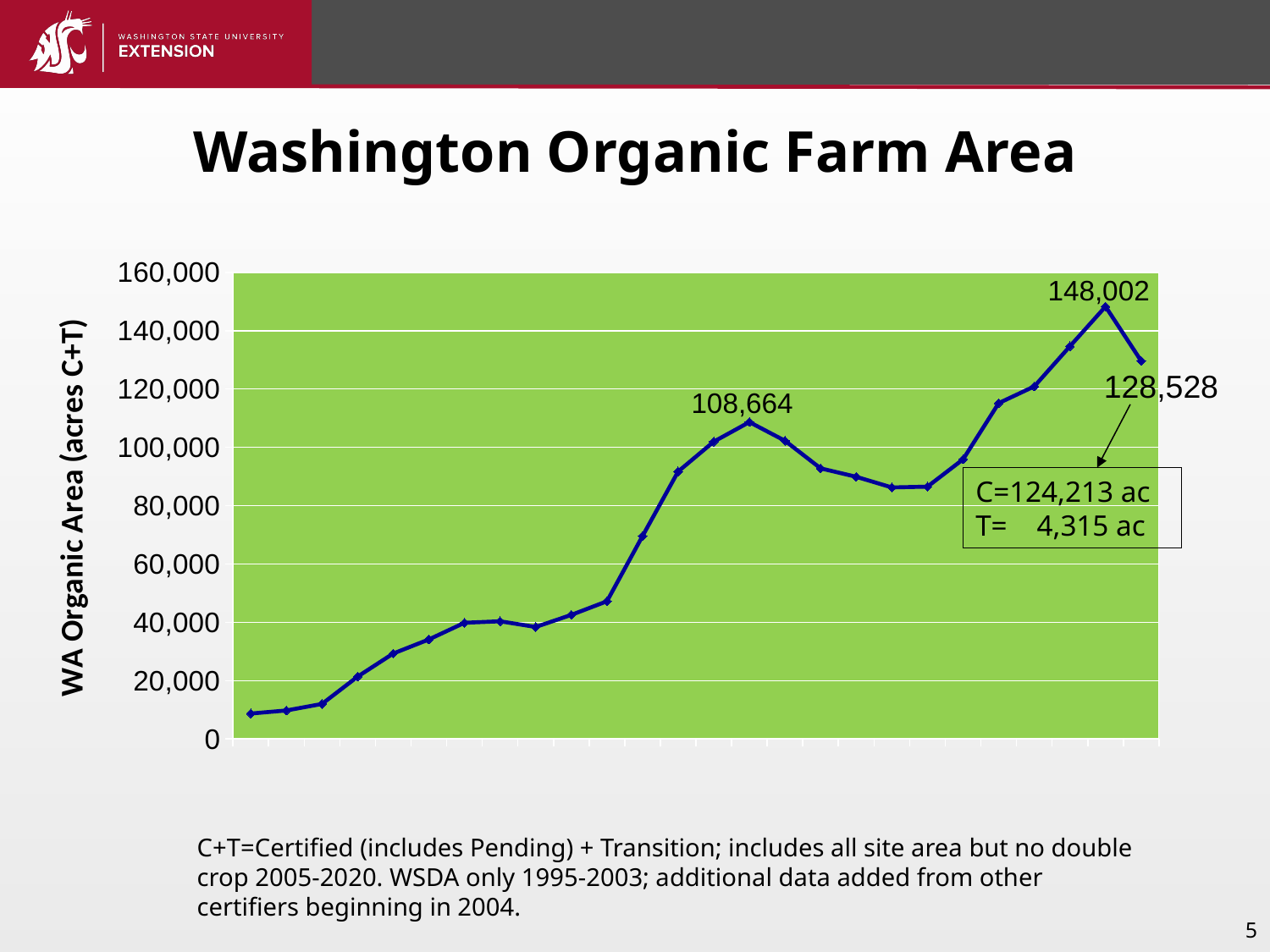
What is the value labeled at the final point of the line? 128,528 What is the difference between the peak value of 148,002 and the final value of 128,528? 19,474 What is the difference between the labeled peak of 148,002 and the earlier labeled peak of 108,664? 39,338 What is the label on the vertical axis of the chart? WA Organic Area (acres C+T) Is the value at the first point of the line greater or less than 20,000? less What is the value labeled at the earlier, middle peak of the line? 108,664 What is the highest value labeled on the line? 148,002 Overall, do the values rise or fall from the left of the chart to the right? rise What is the certified (C) acreage given in the text box for the final point? 124,213 ac What is the transition (T) acreage given in the text box for the final point? 4,315 ac What is the title of the chart? Washington Organic Farm Area What kind of chart is shown on the slide? line chart